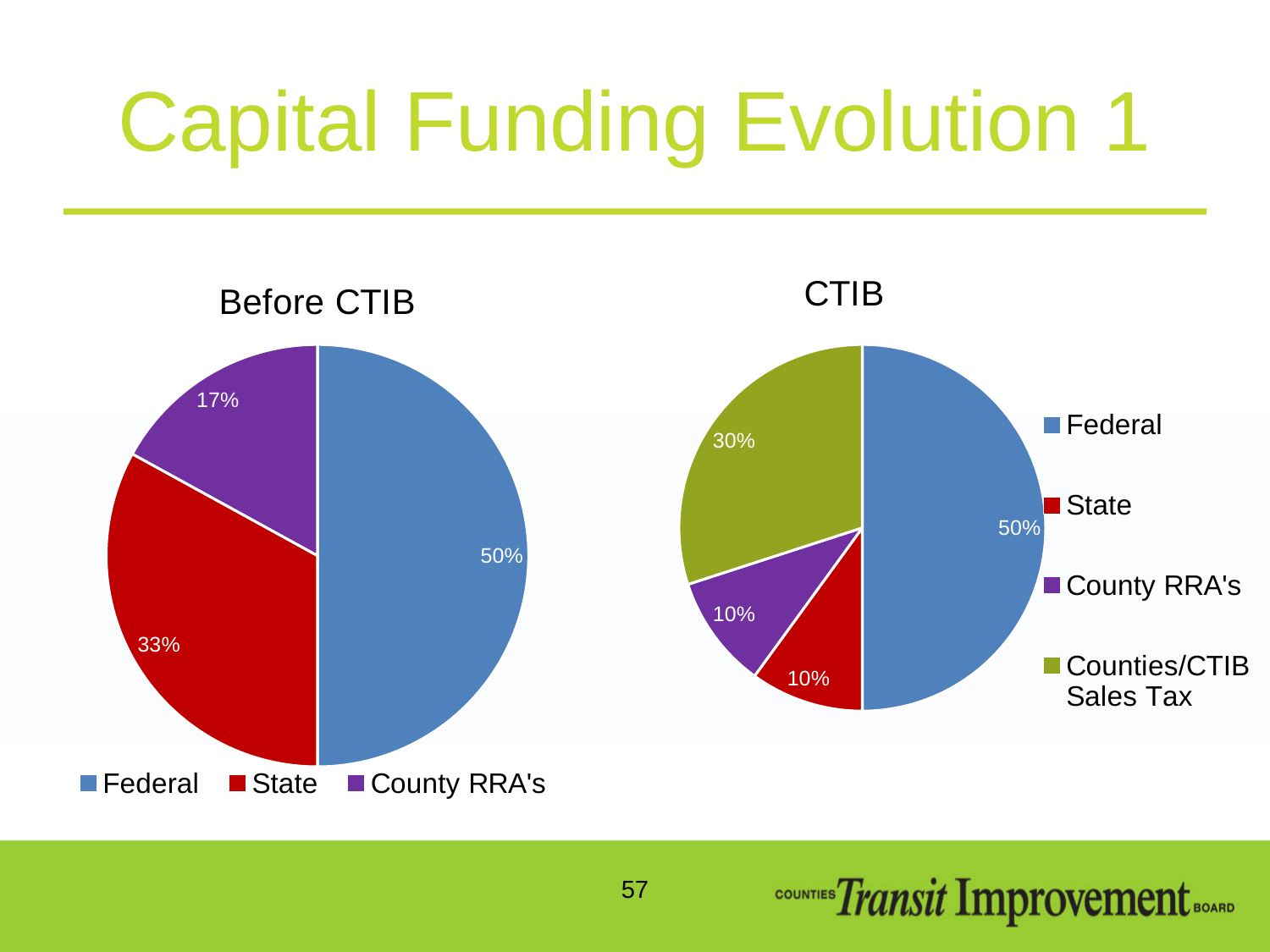
In the "Before CTIB" chart, what share does County RRA's have? 17% In the "Before CTIB" chart, what share does Federal have? 50% In the "Before CTIB" chart, which category has the smallest slice? County RRA's In the "Before CTIB" chart, what is the difference between the State share and the County RRA's share? 16% In the "CTIB" chart, which category has the largest slice? Federal In the "CTIB" chart, which is larger, the State slice or the Counties/CTIB Sales Tax slice? Counties/CTIB Sales Tax In the "Before CTIB" chart, what share does State have? 33% In the "CTIB" chart, what share does Counties/CTIB Sales Tax have? 30% In the "CTIB" chart, what is the difference between the Federal share and the Counties/CTIB Sales Tax share? 20% How many categories does the "CTIB" chart's legend list? 4 What kind of chart is the "Before CTIB" chart? Pie chart In the "CTIB" chart, what share does State have? 10%